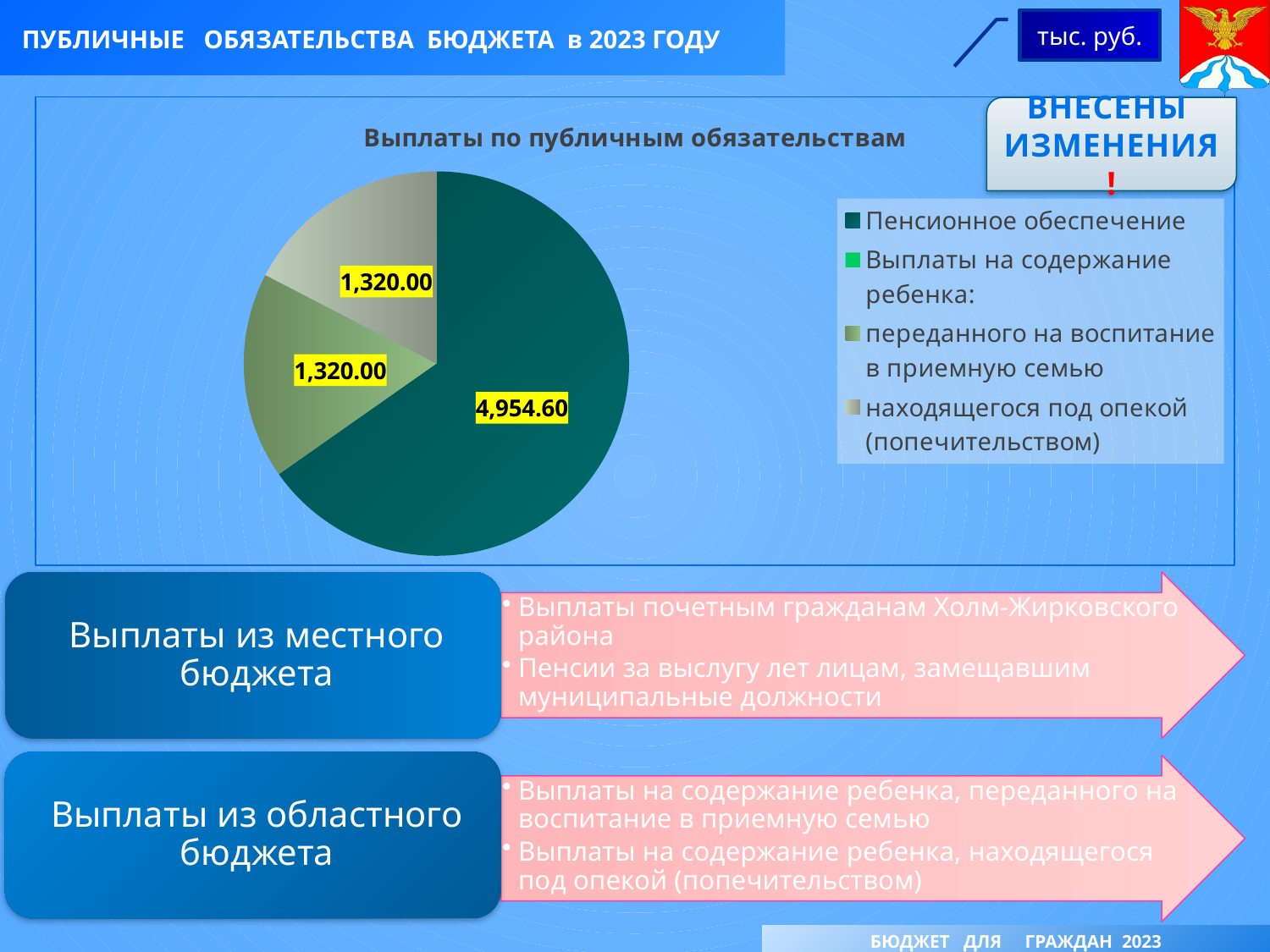
What is the total of the three labelled slices in the pie chart? 7,594.60 What is the value for the slice for a child находящегося под опекой (попечительством)? 1,320.00 What is the value for the slice for a child переданного на воспитание в приемную семью? 1,320.00 What is the title of the chart? Выплаты по публичным обязательствам What is the difference between the value for Пенсионное обеспечение and the value for a child переданного на воспитание в приемную семью? 3,634.60 In what units are the chart values given, according to the box at the top of the slide? тыс. руб. How many entries does the chart legend list? 4 Which category has the largest slice in the pie chart? Пенсионное обеспечение Which is larger: the value for Пенсионное обеспечение or the value for a child находящегося под опекой (попечительством)? Пенсионное обеспечение What type of chart is shown on the slide? pie chart What is the value for Пенсионное обеспечение in the pie chart? 4,954.60 How many slices with data labels are shown in the pie chart? 3